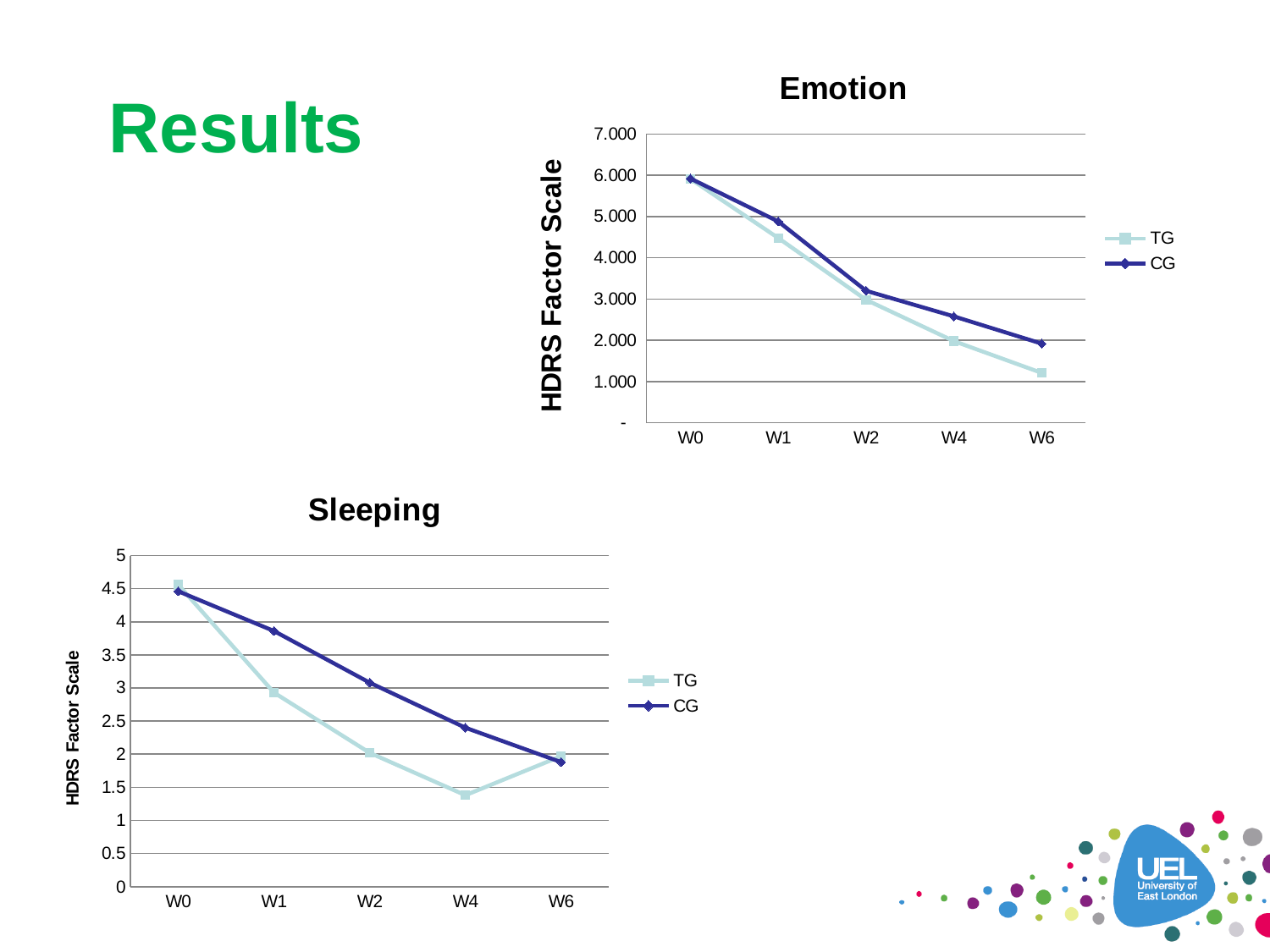
In the Emotion chart, do the TG values rise or fall from W0 to W6? fall In the Emotion chart, is the TG value at W2 greater or less than 4.000? less In the Sleeping chart, is the TG value at W4 greater or less than 2? less In the Sleeping chart, at which week is the TG value lowest? W4 How many series does the legend of the Sleeping chart list? 2 What is the y-axis label of the Sleeping chart? HDRS Factor Scale In the Emotion chart, is the CG value at W4 greater or less than 2.000? greater In the Sleeping chart, which series has the higher value at W4, TG or CG? CG How many time points are shown on the x axis of the Emotion chart? 5 In the Emotion chart, which series has the higher value at W6, TG or CG? CG What kind of chart is the Emotion chart? line chart